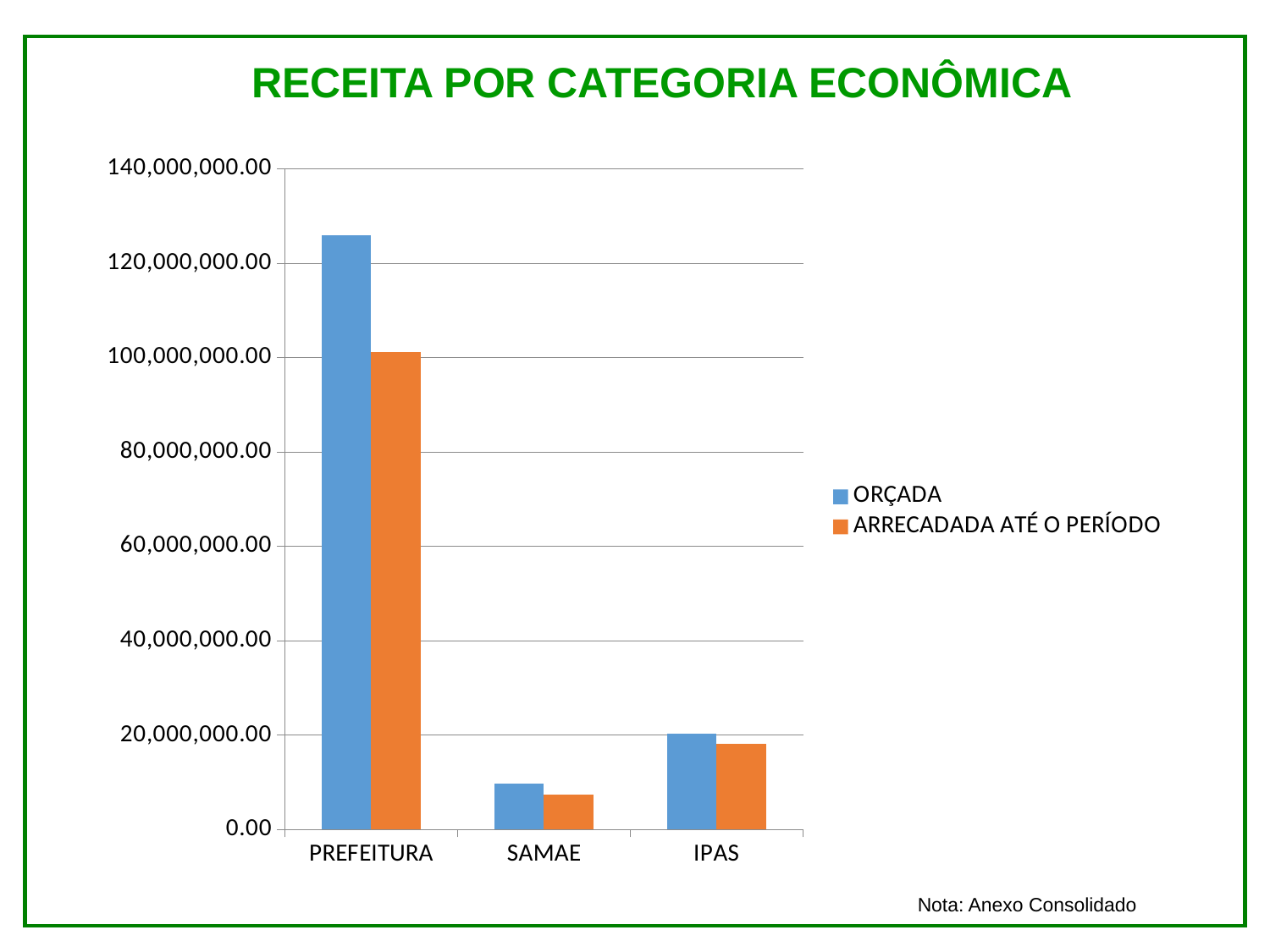
How many categories are shown on the x axis? 3 Which category has the highest ORÇADA value? PREFEITURA How many series does the legend list? 2 Is the ORÇADA value for SAMAE greater or less than 20,000,000.00? less What is the title of the chart? RECEITA POR CATEGORIA ECONÔMICA Is the ORÇADA value for PREFEITURA greater or less than 120,000,000.00? greater For PREFEITURA, which is larger: the ORÇADA value or the ARRECADADA ATÉ O PERÍODO value? ORÇADA Is the ARRECADADA ATÉ O PERÍODO value for PREFEITURA greater or less than 120,000,000.00? less Which category has a larger ORÇADA value, SAMAE or IPAS? IPAS What type of chart is shown on the slide? bar chart Which category has the lowest ARRECADADA ATÉ O PERÍODO value? SAMAE